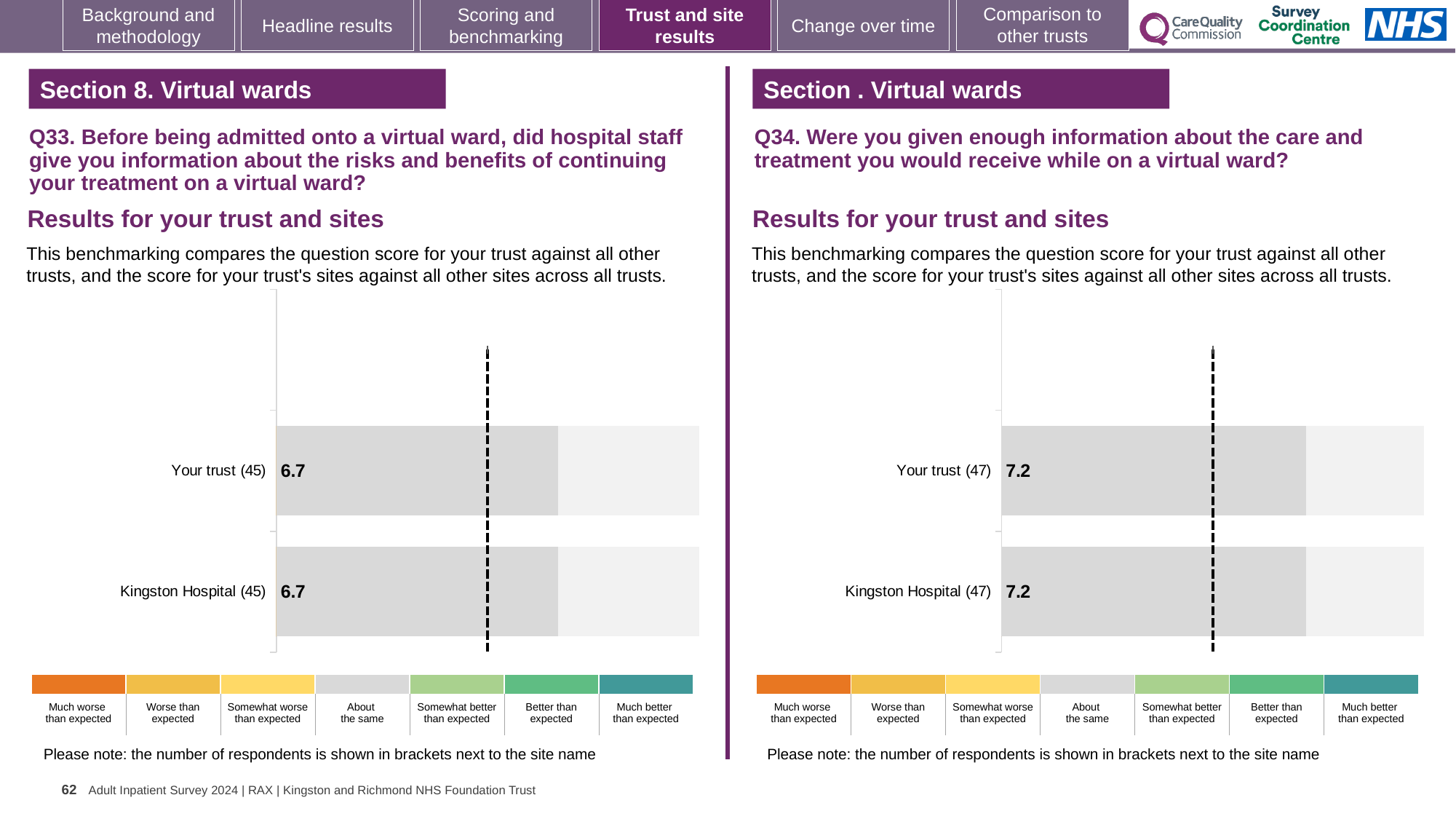
How many bars are plotted on the Q33 chart (left)? 2 How many bars are plotted on the Q34 chart (right)? 2 On the Q34 chart (right), how many respondents are shown in brackets for Your trust? 47 What kind of chart is used on the Q33 chart (left)? Bar chart On the Q33 chart (left), what is the difference between the scores for Your trust and Kingston Hospital? 0 Is the score for Your trust on the Q34 chart (right) larger or smaller than the score for Your trust on the Q33 chart (left)? Larger On the Q34 chart (right), what is the score for Kingston Hospital (47)? 7.2 On the Q33 chart (left), what is the score for Kingston Hospital (45)? 6.7 On the Q34 chart (right), what is the difference between the scores for Your trust and Kingston Hospital? 0 On the Q34 chart (right), what is the score for Your trust (47)? 7.2 On the Q33 chart (left), what is the score for Your trust (45)? 6.7 On the Q33 chart (left), how many respondents are shown in brackets for Kingston Hospital? 45